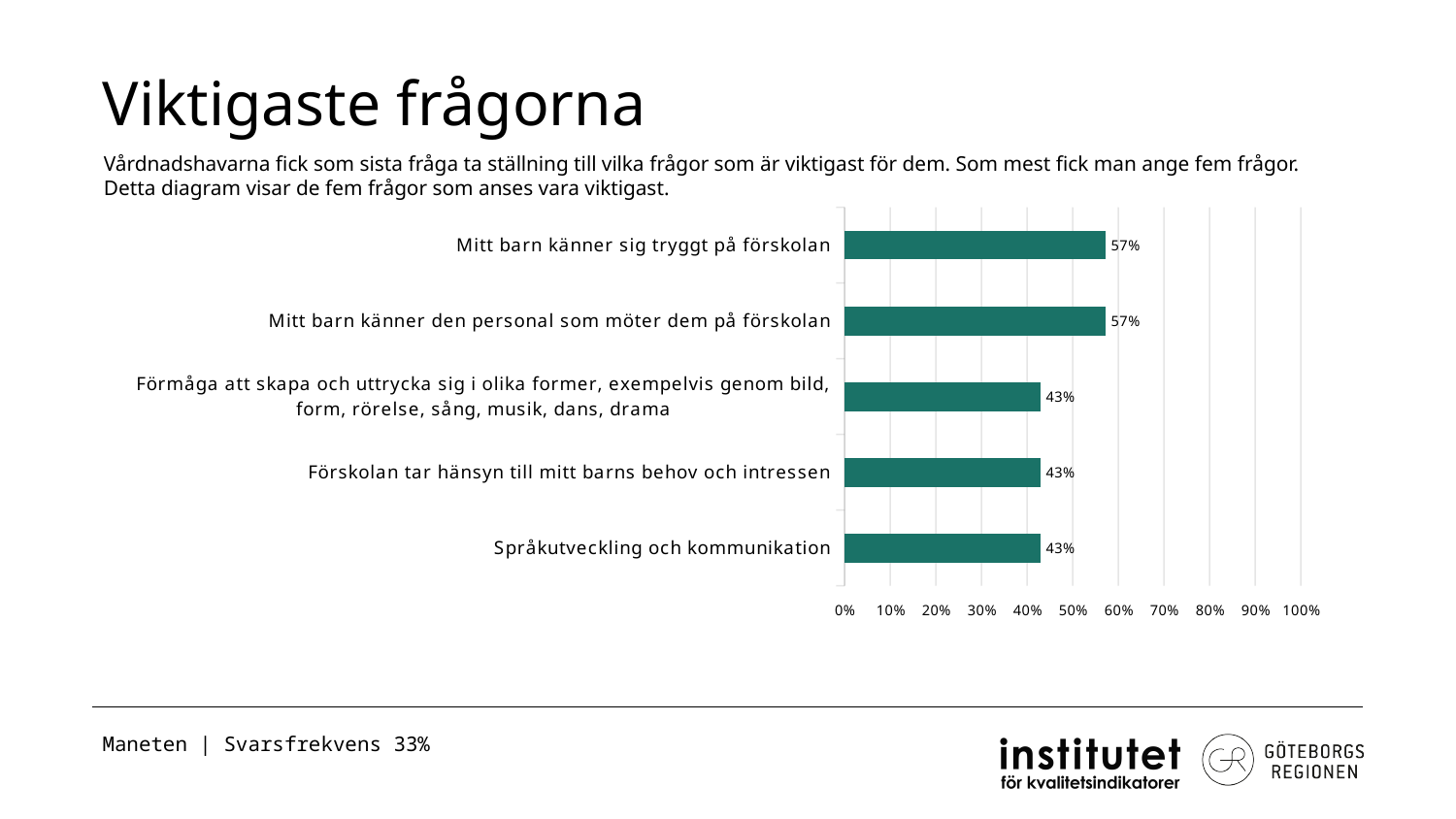
Which is larger: the value for "Mitt barn känner den personal som möter dem på förskolan" or the value for "Förskolan tar hänsyn till mitt barns behov och intressen"? Mitt barn känner den personal som möter dem på förskolan Is the value for "Mitt barn känner sig tryggt på förskolan" greater or less than 50%? greater What is the value for "Språkutveckling och kommunikation"? 43% Is the value for "Språkutveckling och kommunikation" greater or less than 50%? less What is the value for "Mitt barn känner sig tryggt på förskolan"? 57% What is the value for "Mitt barn känner den personal som möter dem på förskolan"? 57% What is the value for "Förskolan tar hänsyn till mitt barns behov och intressen"? 43% What is the difference between the value for "Mitt barn känner sig tryggt på förskolan" and the value for "Språkutveckling och kommunikation"? 14% What kind of chart is shown on the slide? bar chart What is the title of the slide? Viktigaste frågorna How many categories are shown in the chart? 5 What is the maximum value shown on the x axis of the chart? 100%